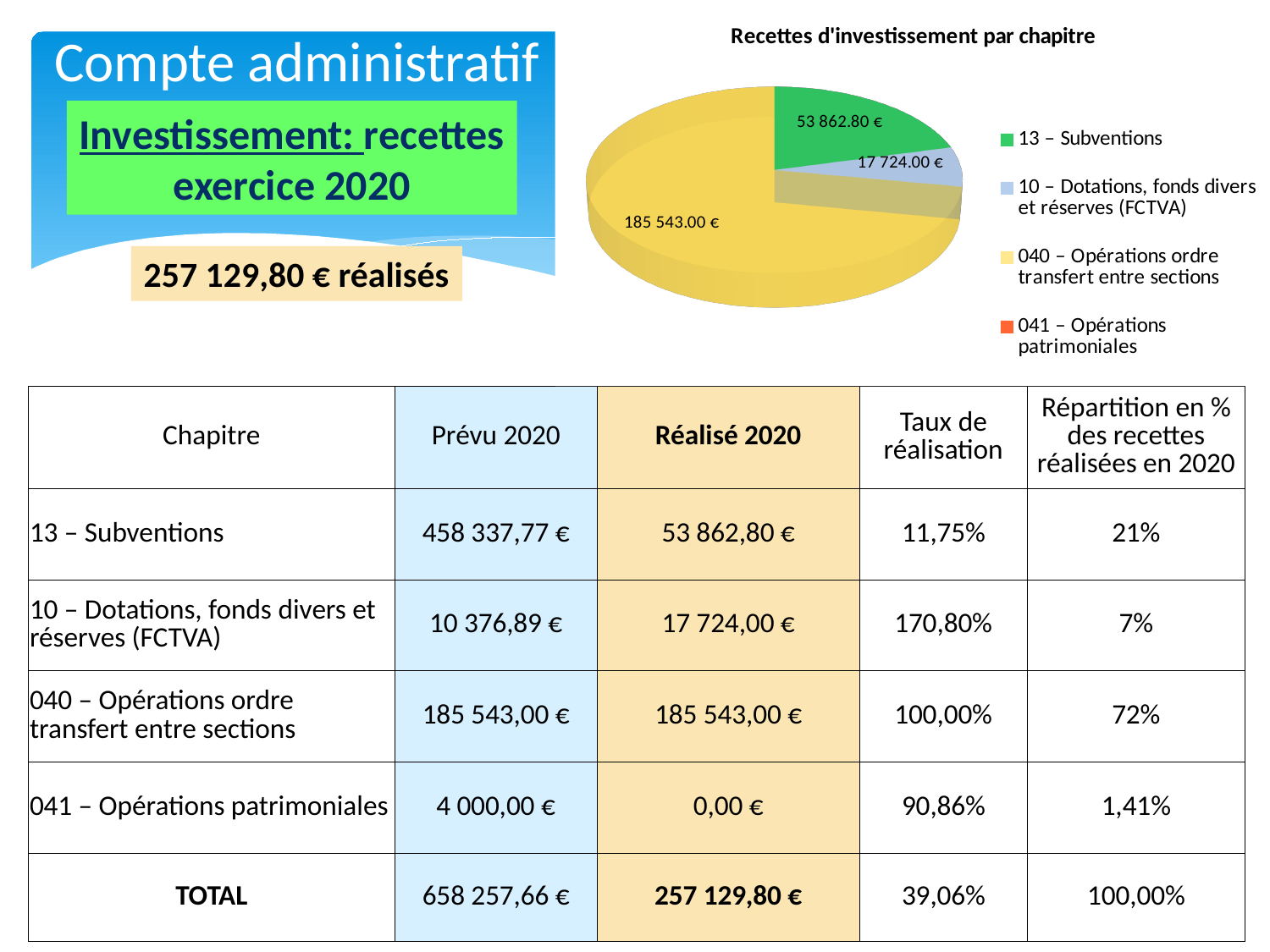
What colour is the slice for 13 – Subventions in the pie chart? green What type of chart is shown on the slide? pie chart What is the total of the values labelled on the pie chart? 257 129.80 € How many entries does the chart's legend list? 4 What is the title of the chart? Recettes d'investissement par chapitre What value is shown for 13 – Subventions in the pie chart? 53 862.80 € What is the difference between the values for 040 – Opérations ordre transfert entre sections and 13 – Subventions in the pie chart? 131 680.20 € Which of the labelled slices in the pie chart is the smallest? 10 – Dotations, fonds divers et réserves (FCTVA) Which category has the largest slice in the pie chart? 040 – Opérations ordre transfert entre sections What value is shown for 040 – Opérations ordre transfert entre sections in the pie chart? 185 543.00 € Which is larger in the pie chart: 13 – Subventions or 10 – Dotations, fonds divers et réserves (FCTVA)? 13 – Subventions What value is shown for 10 – Dotations, fonds divers et réserves (FCTVA) in the pie chart? 17 724.00 €